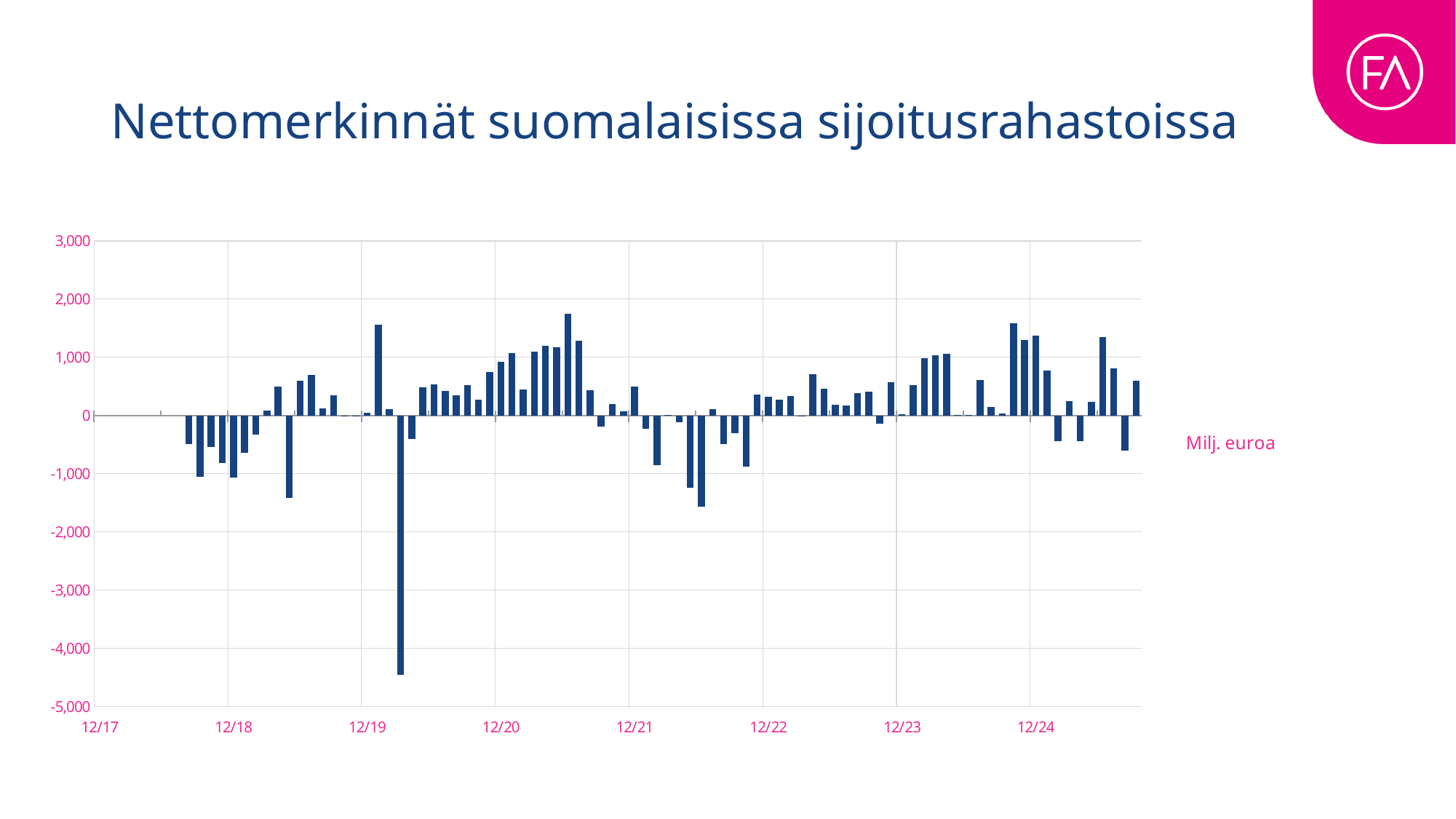
What kind of chart is shown on the slide? bar chart What is the title of the chart? Nettomerkinnät suomalaisissa sijoitusrahastoissa Between which two x-axis labels does the lowest bar on the chart appear? 12/19 and 12/20 Are the bars between 12/21 and 12/22 mostly positive or mostly negative? mostly negative What unit is indicated next to the chart? Milj. euroa How many labels are shown on the x axis? 8 Is the value of the highest bar on the chart greater or less than 1,000? greater Is the value of the tallest bar between 12/19 and 12/20 greater or less than 1,000? greater Is the value of the lowest bar on the chart greater or less than -4,000? less What is the highest value shown on the y axis? 3,000 What is the lowest value shown on the y axis? -5,000